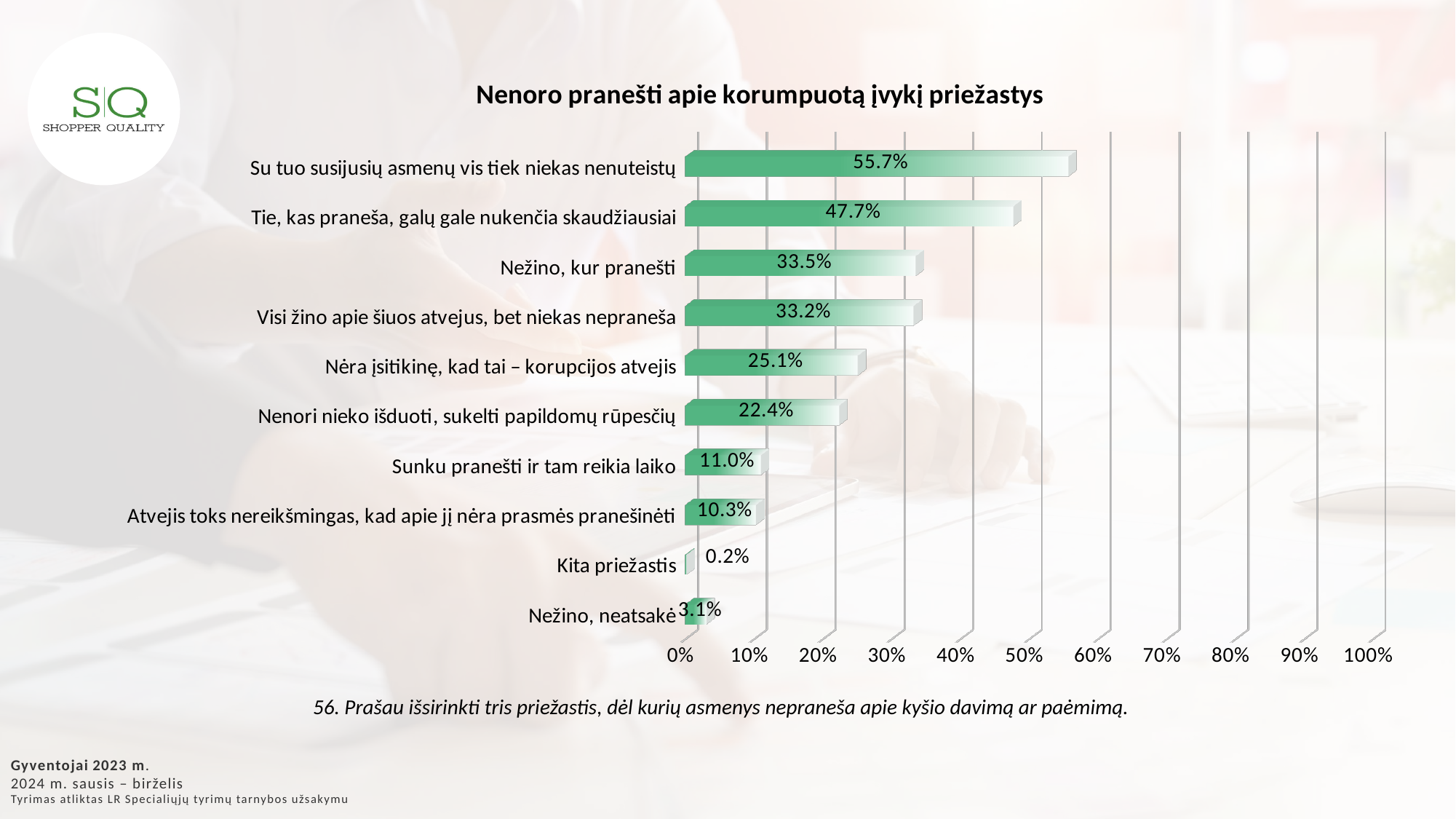
What is the difference between "Su tuo susijusių asmenų vis tiek niekas nenuteistų" and "Tie, kas praneša, galų gale nukenčia skaudžiausiai"? 8.0% Which category has the lowest value? Kita priežastis What is the value for "Nežino, kur pranešti"? 33.5% How many categories are shown in the chart? 10 What is the value for "Sunku pranešti ir tam reikia laiko"? 11.0% What is the value for "Kita priežastis"? 0.2% What kind of chart is shown on the slide? bar chart Which is larger: "Nėra įsitikinę, kad tai – korupcijos atvejis" or "Nenori nieko išduoti, sukelti papildomų rūpesčių"? Nėra įsitikinę, kad tai – korupcijos atvejis What is the value for "Nežino, neatsakė"? 3.1% What is the title of the chart? Nenoro pranešti apie korumpuotą įvykį priežastys Which category has the highest value? Su tuo susijusių asmenų vis tiek niekas nenuteistų Is the value for "Tie, kas praneša, galų gale nukenčia skaudžiausiai" greater or less than 50%? less